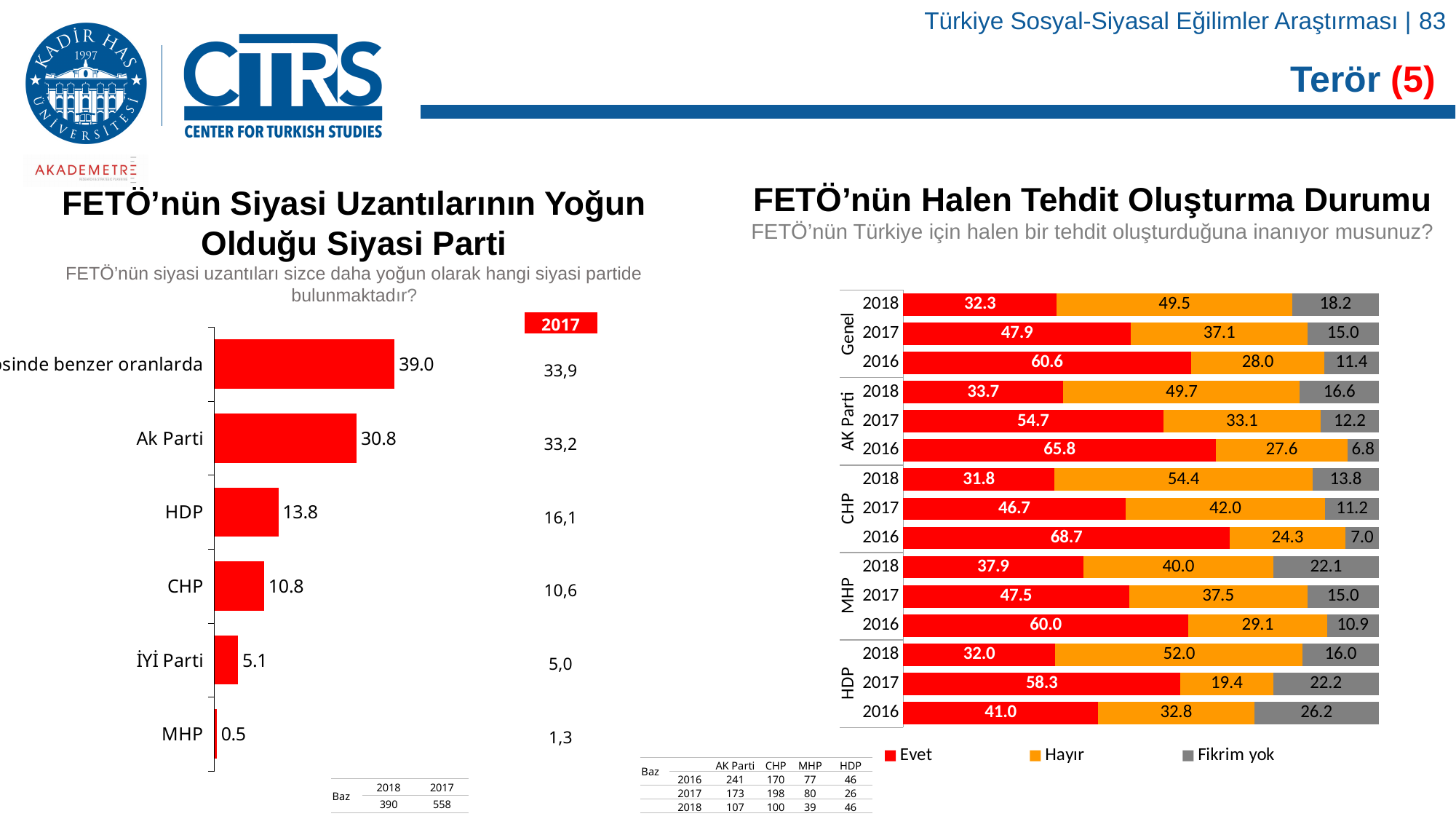
In the chart 'FETÖ'nün Halen Tehdit Oluşturma Durumu', what is the Fikrim yok value for HDP in 2016? 26.2 In the chart 'FETÖ'nün Siyasi Uzantılarının Yoğun Olduğu Siyasi Parti', what is the 2017 value shown for Ak Parti? 33,2 In the chart 'FETÖ'nün Siyasi Uzantılarının Yoğun Olduğu Siyasi Parti', what is the value for HDP? 13.8 In the chart 'FETÖ'nün Siyasi Uzantılarının Yoğun Olduğu Siyasi Parti', what is the difference between the values for CHP and İYİ Parti? 5.7 In the chart 'FETÖ'nün Halen Tehdit Oluşturma Durumu', what is the difference between the Hayır values for MHP in 2018 and 2017? 2.5 In the chart 'FETÖ'nün Siyasi Uzantılarının Yoğun Olduğu Siyasi Parti', which party has the lowest value? MHP In the chart 'FETÖ'nün Siyasi Uzantılarının Yoğun Olduğu Siyasi Parti', what is the value for Ak Parti? 30.8 In the chart 'FETÖ'nün Halen Tehdit Oluşturma Durumu', what is the Evet value for Genel in 2018? 32.3 In the chart 'FETÖ'nün Halen Tehdit Oluşturma Durumu', how does the Evet value for CHP change from 2016 to 2018? It falls What kind of chart is 'FETÖ'nün Halen Tehdit Oluşturma Durumu'? Stacked bar chart In the chart 'FETÖ'nün Siyasi Uzantılarının Yoğun Olduğu Siyasi Parti', which is larger: the value for HDP or the value for CHP? HDP In the chart 'FETÖ'nün Halen Tehdit Oluşturma Durumu', how many series does the legend list? 3